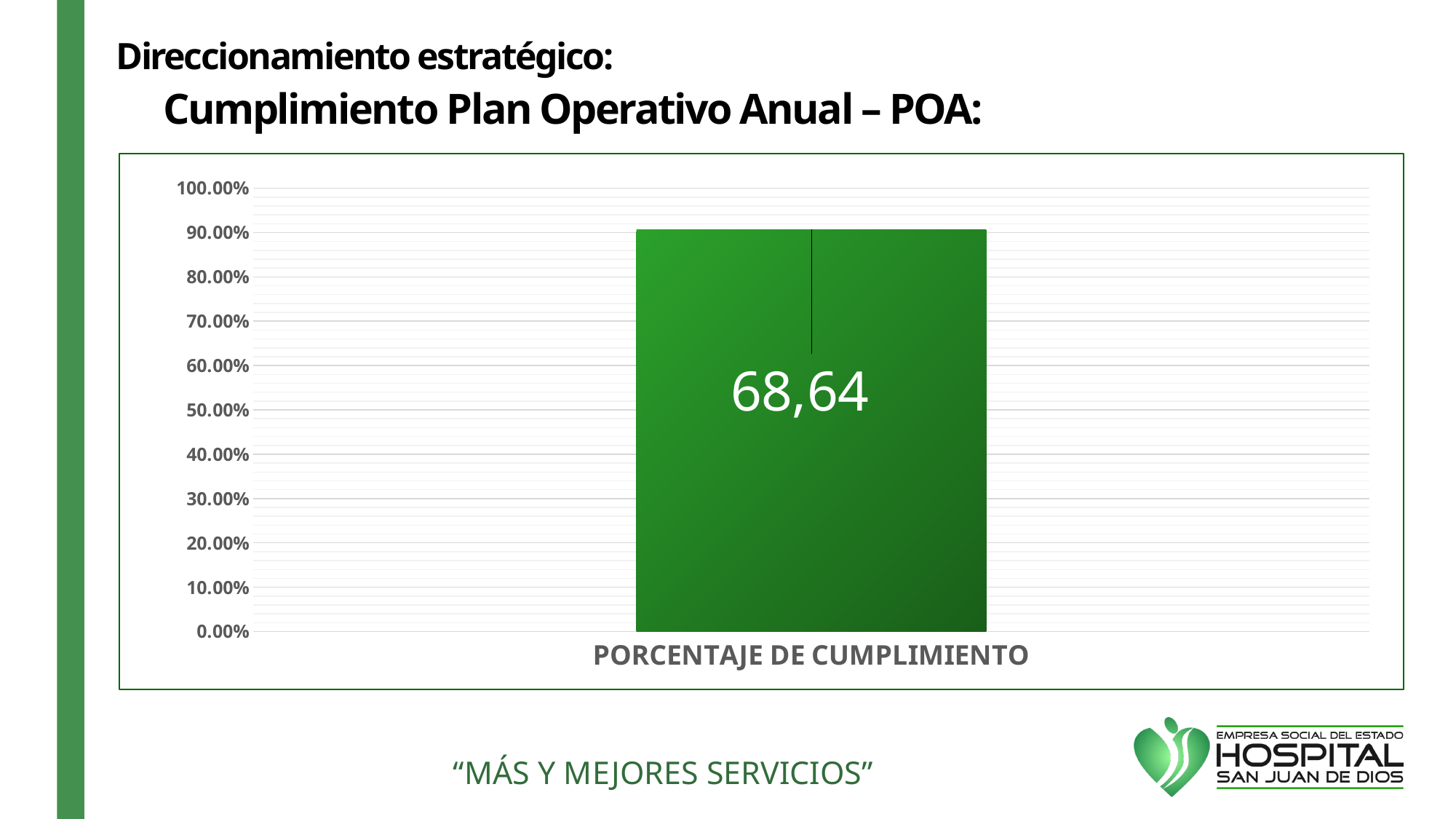
What is the lowest value shown on the vertical axis? 0.00% How many bars does the chart contain? 1 What is the category label shown under the bar? PORCENTAJE DE CUMPLIMIENTO Is the value for PORCENTAJE DE CUMPLIMIENTO greater or less than 60.00%? greater What kind of chart is shown on the slide? bar chart What is the highest value shown on the vertical axis? 100.00% Is the value for PORCENTAJE DE CUMPLIMIENTO greater or less than 50.00%? greater What value is printed on the bar for PORCENTAJE DE CUMPLIMIENTO? 68,64